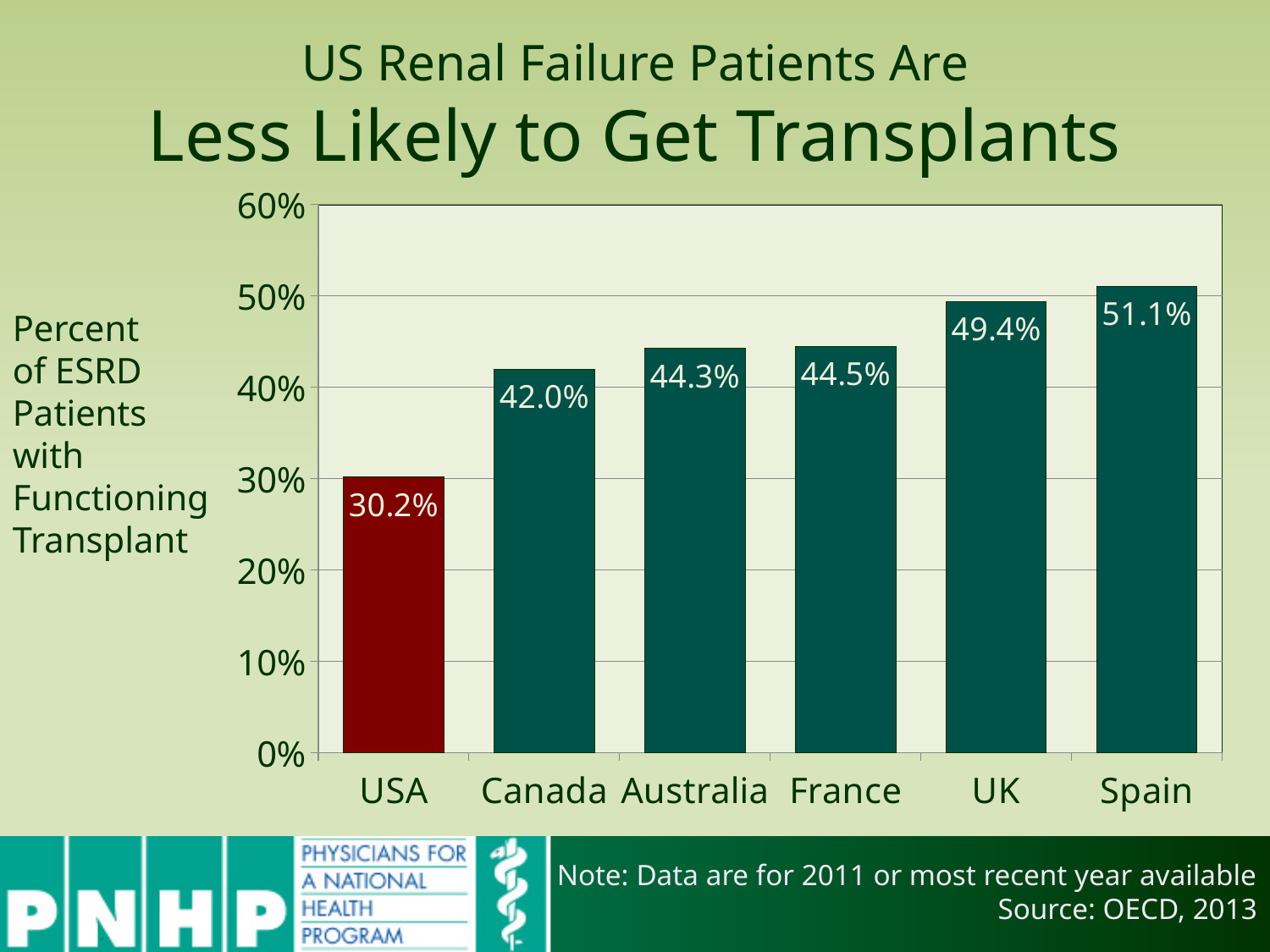
Which is larger, the value for Canada or the value for the UK? UK Which country has the highest percentage of ESRD patients with a functioning transplant? Spain What kind of chart is shown on the slide? Bar chart How many countries are shown in the chart? 6 Which bar is coloured differently (dark red) from the others? USA What is the difference between the values for the UK and Canada? 7.4% What is the difference between the values for Spain and the USA? 20.9% Which country has the lowest percentage of ESRD patients with a functioning transplant? USA What is the value for the UK? 49.4% What is the value for Canada? 42.0% What is the value for the USA? 30.2% Is the value for France greater or less than 40%? greater